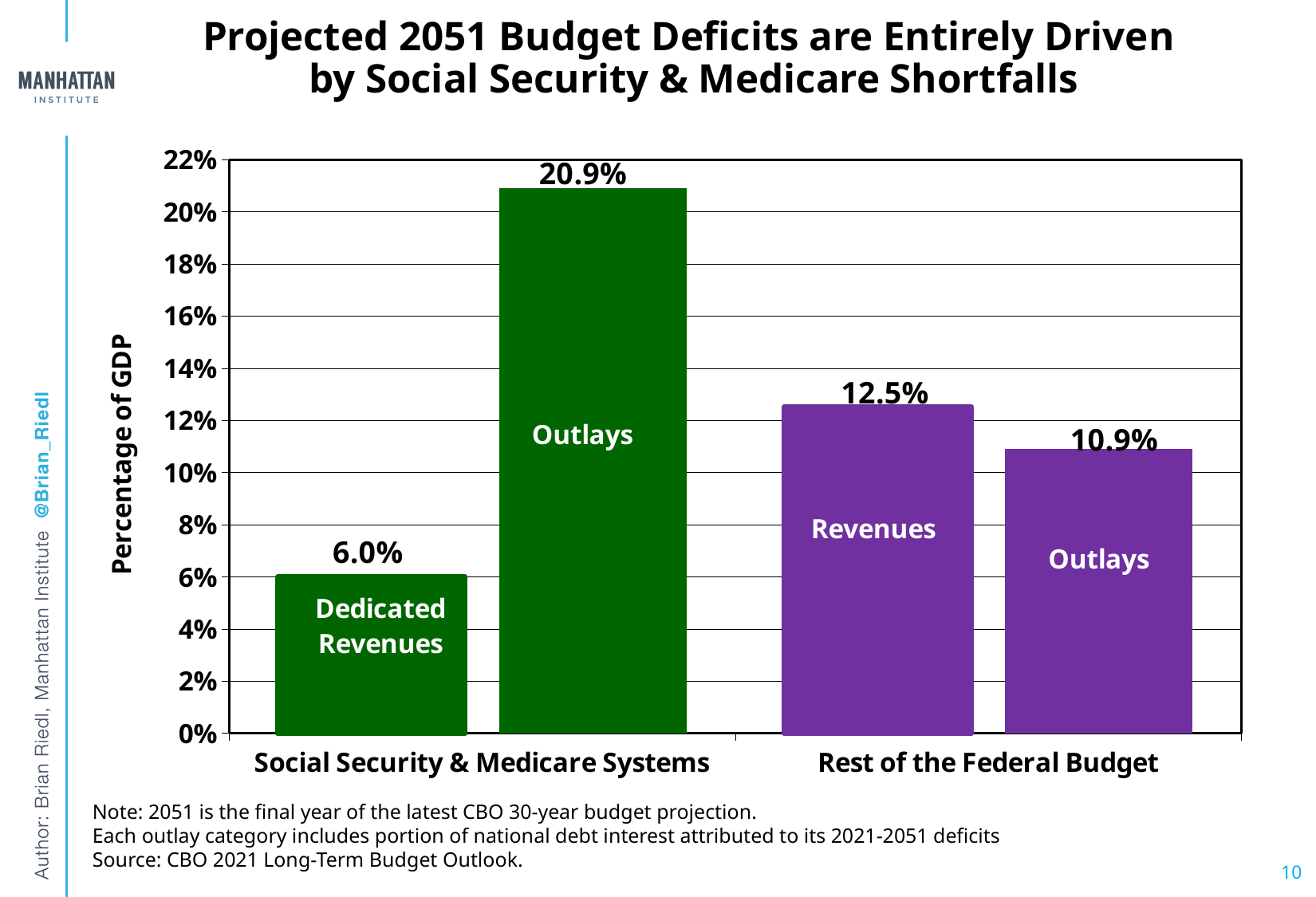
What is the value for Revenues in the Rest of the Federal Budget group? 12.5% What is the label of the vertical axis? Percentage of GDP What is the difference between Revenues and Outlays for the Rest of the Federal Budget? 1.6% Which bar has the highest value on the chart? Outlays (Social Security & Medicare Systems) How many bars are plotted on the chart? 4 In the Rest of the Federal Budget group, which is larger, Revenues or Outlays? Revenues What kind of chart is shown on the slide? Bar chart What is the value for Dedicated Revenues in the Social Security & Medicare Systems group? 6.0% What is the value for Outlays in the Social Security & Medicare Systems group? 20.9% What is the value for Outlays in the Rest of the Federal Budget group? 10.9% What is the difference between Outlays and Dedicated Revenues for Social Security & Medicare Systems? 14.9% Which bar has the lowest value on the chart? Dedicated Revenues (Social Security & Medicare Systems)